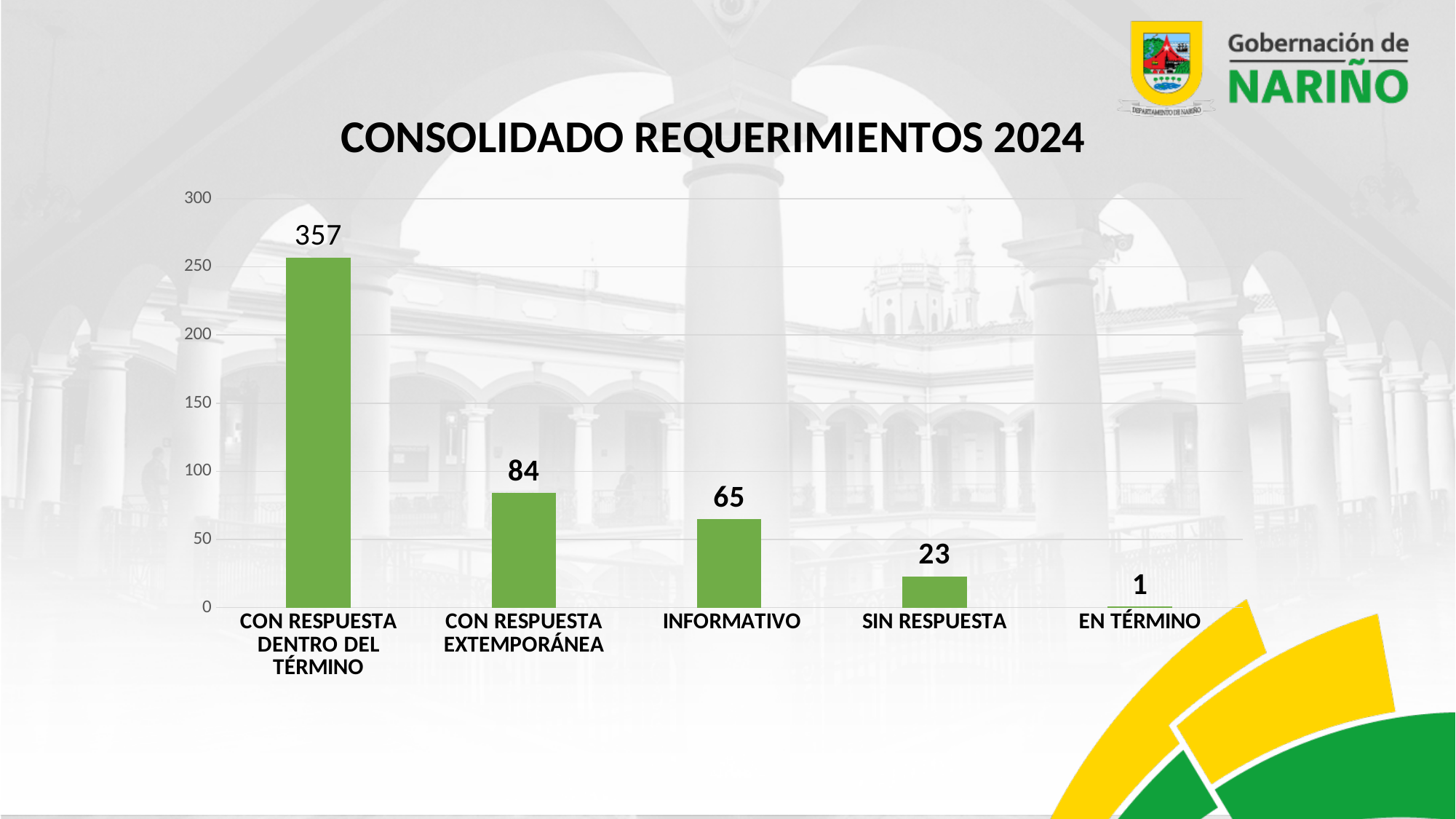
What kind of chart is shown on the slide? Bar chart What is the difference between the values for CON RESPUESTA EXTEMPORÁNEA and INFORMATIVO? 19 What is the value for SIN RESPUESTA? 23 What is the value for CON RESPUESTA DENTRO DEL TÉRMINO? 357 What is the title of the chart? CONSOLIDADO REQUERIMIENTOS 2024 How many categories are shown in the chart? 5 Which category has the lowest value? EN TÉRMINO Which is larger, the value for INFORMATIVO or the value for SIN RESPUESTA? INFORMATIVO Which category has the highest value? CON RESPUESTA DENTRO DEL TÉRMINO What is the value for CON RESPUESTA EXTEMPORÁNEA? 84 What is the value for EN TÉRMINO? 1 What is the value for INFORMATIVO? 65